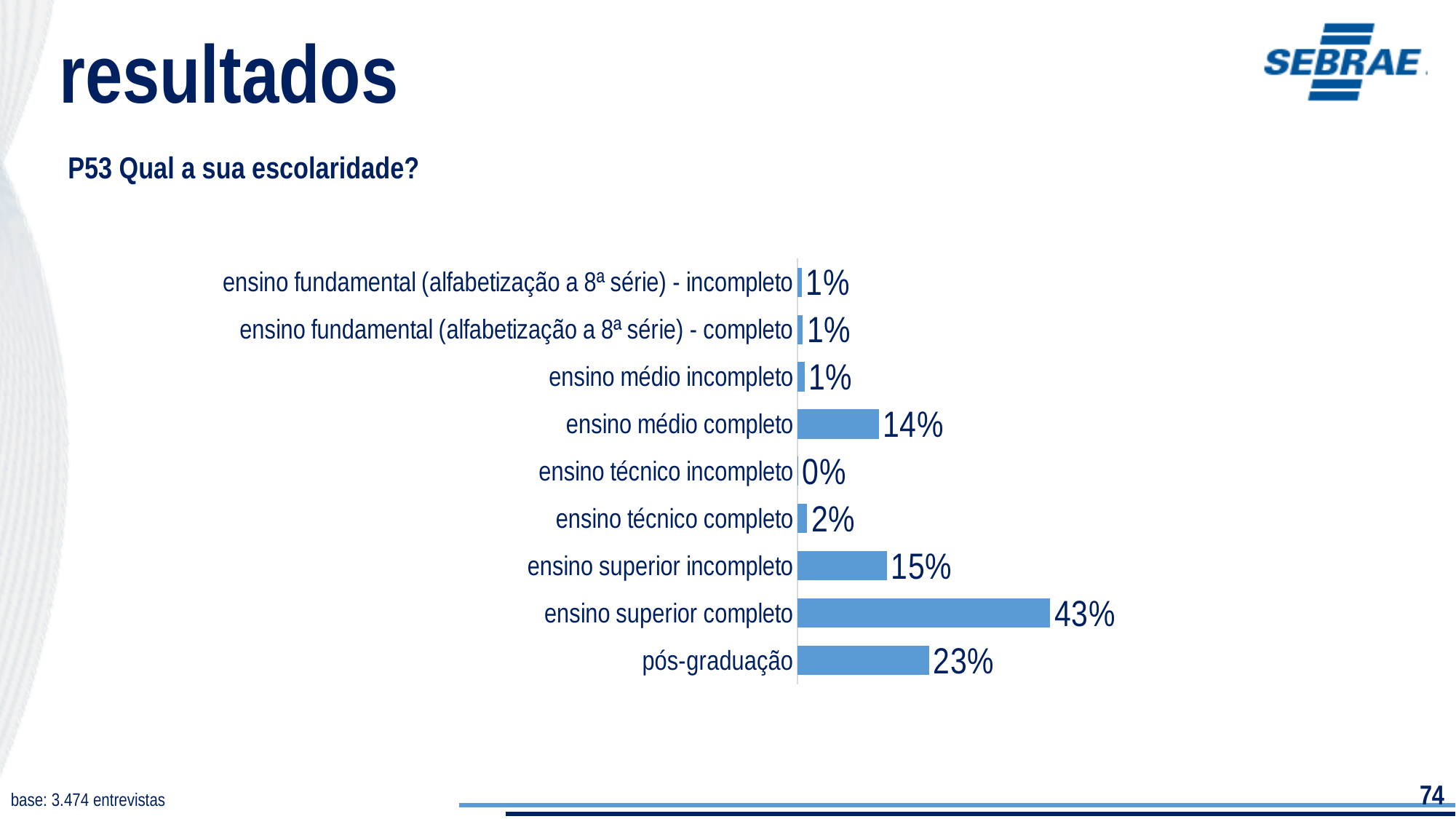
How many categories are shown in the chart? 9 What is the value for ensino médio completo? 14% What is the value for ensino técnico completo? 2% What is the question text shown above the chart? P53 Qual a sua escolaridade? Which category has the lowest value? ensino técnico incompleto What is the value for ensino técnico incompleto? 0% What kind of chart is shown on the slide? bar chart What is the difference between ensino superior completo and pós-graduação? 20% Which category has the highest value? ensino superior completo What is the value for ensino superior completo? 43% Which is larger, ensino superior incompleto or ensino médio completo? ensino superior incompleto What is the value for pós-graduação? 23%